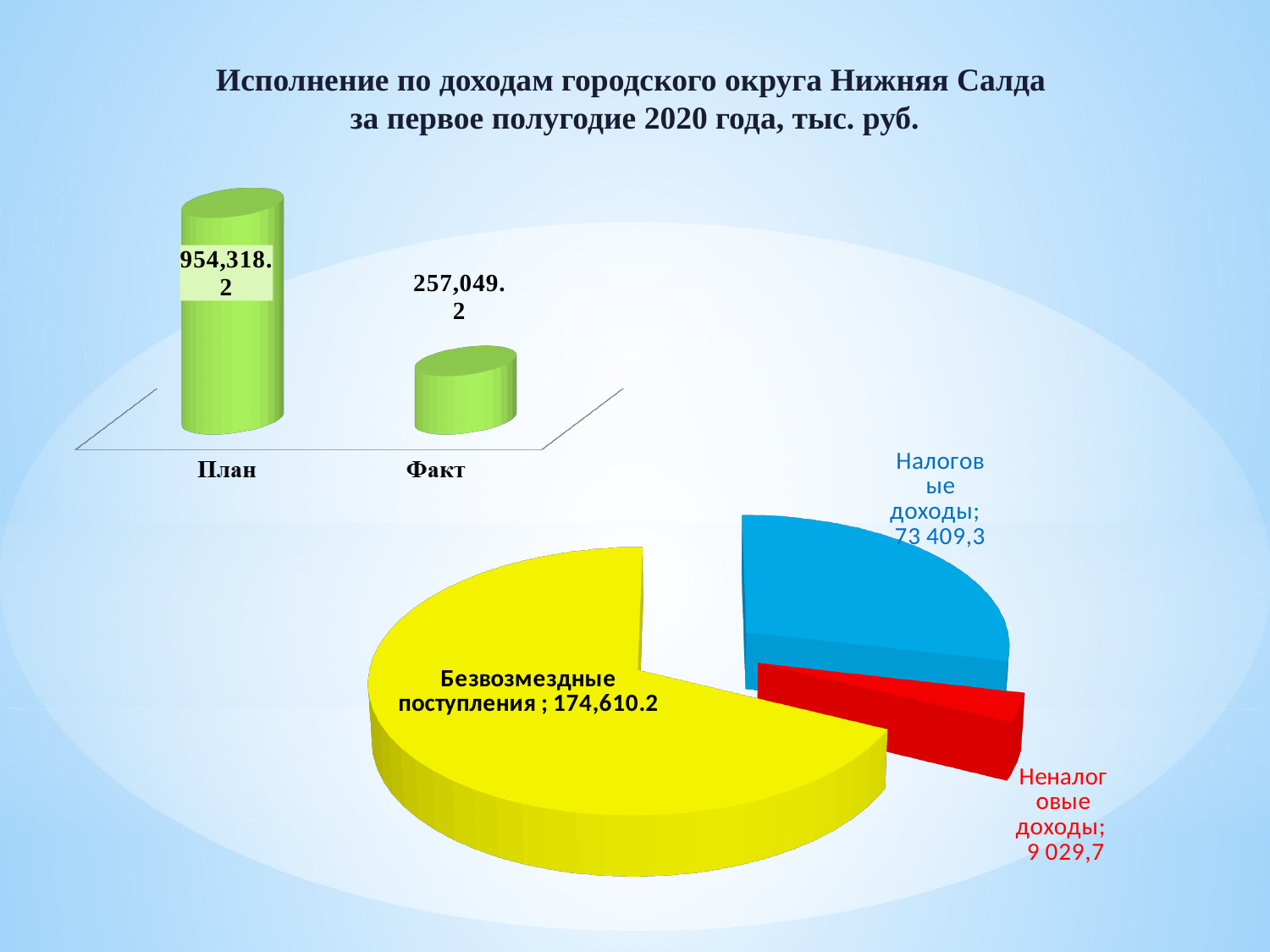
On the pie chart, what is the value for Неналоговые доходы? 9 029,7 On the bar chart at the top left, what is the value for Факт? 257,049.2 On the bar chart at the top left, what is the difference between the План and Факт values? 697,269.0 On the pie chart, which category has the smallest slice? Неналоговые доходы On the pie chart, what colour is the slice for Налоговые доходы? Blue On the pie chart, what is the value for Безвозмездные поступления? 174,610.2 On the bar chart at the top left, which category has the higher value, План or Факт? План What kind of chart is the one at the top left of the slide? Bar chart On the pie chart, which category has the largest slice? Безвозмездные поступления On the bar chart at the top left, what is the value for План? 954,318.2 On the bar chart at the top left, how many categories are shown? 2 On the pie chart, what is the value for Налоговые доходы? 73 409,3